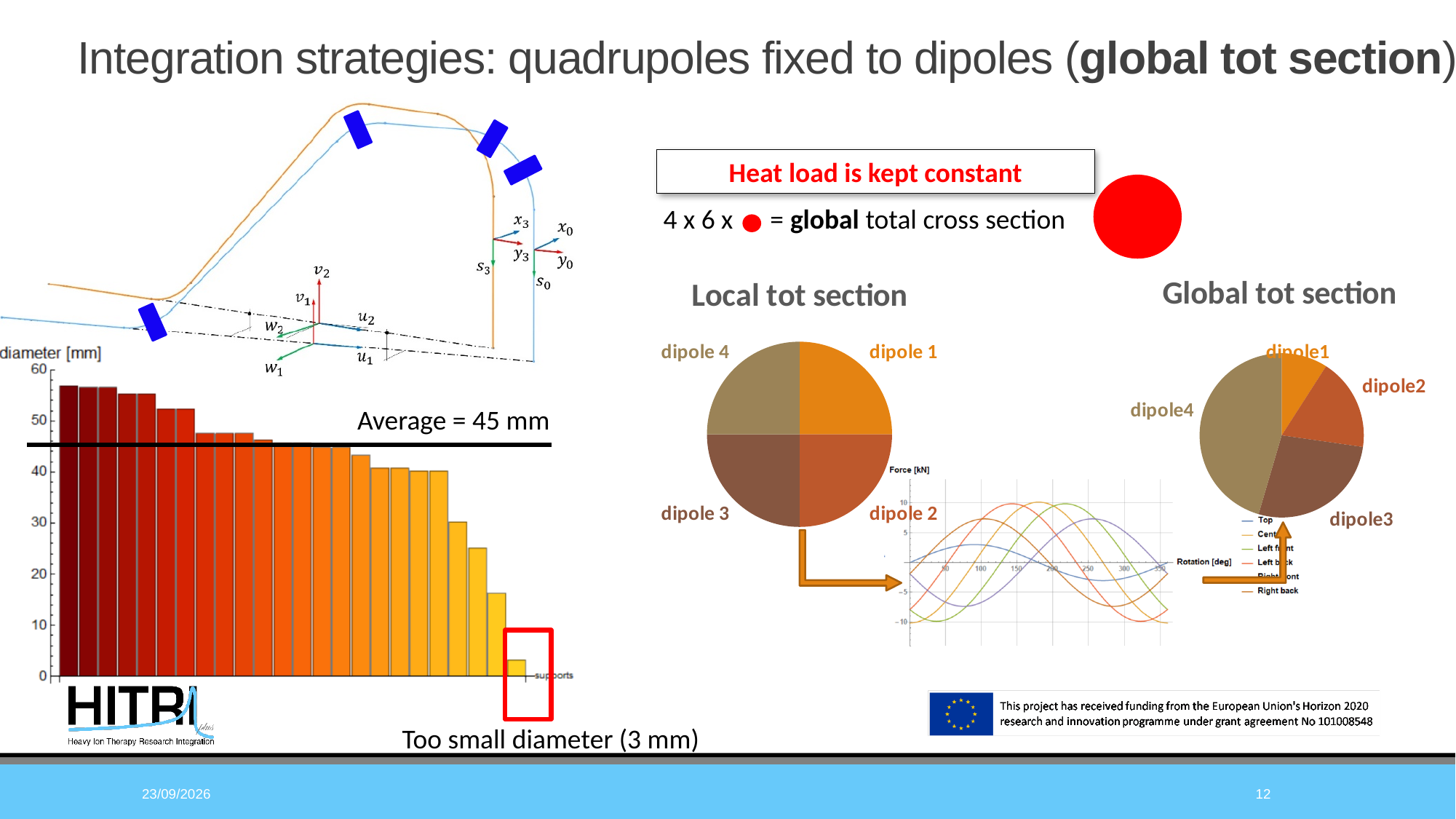
In the 'Global tot section' pie chart, which dipole has the smallest slice? dipole1 In the 'Global tot section' pie chart, which slice is larger, dipole3 or dipole2? dipole3 In the diameter [mm] bar chart, is the value of the leftmost bar greater or less than 50? greater In the diameter [mm] bar chart, what is the value of the smallest bar highlighted by the red box? 3 mm In the diameter [mm] bar chart, what is the average diameter printed on the chart? 45 mm What kind of chart is the diameter [mm] chart on the left of the slide? bar chart In the diameter [mm] bar chart, do the bar values rise or fall from left to right? fall In the diameter [mm] bar chart, is the value of the rightmost bar greater or less than 10? less In the 'Global tot section' pie chart, which dipole has the largest slice? dipole4 What kind of chart is the 'Local tot section' chart? pie chart How many slices does the 'Local tot section' pie chart have? 4 What kind of chart is the Force [kN] versus Rotation [deg] chart? line chart